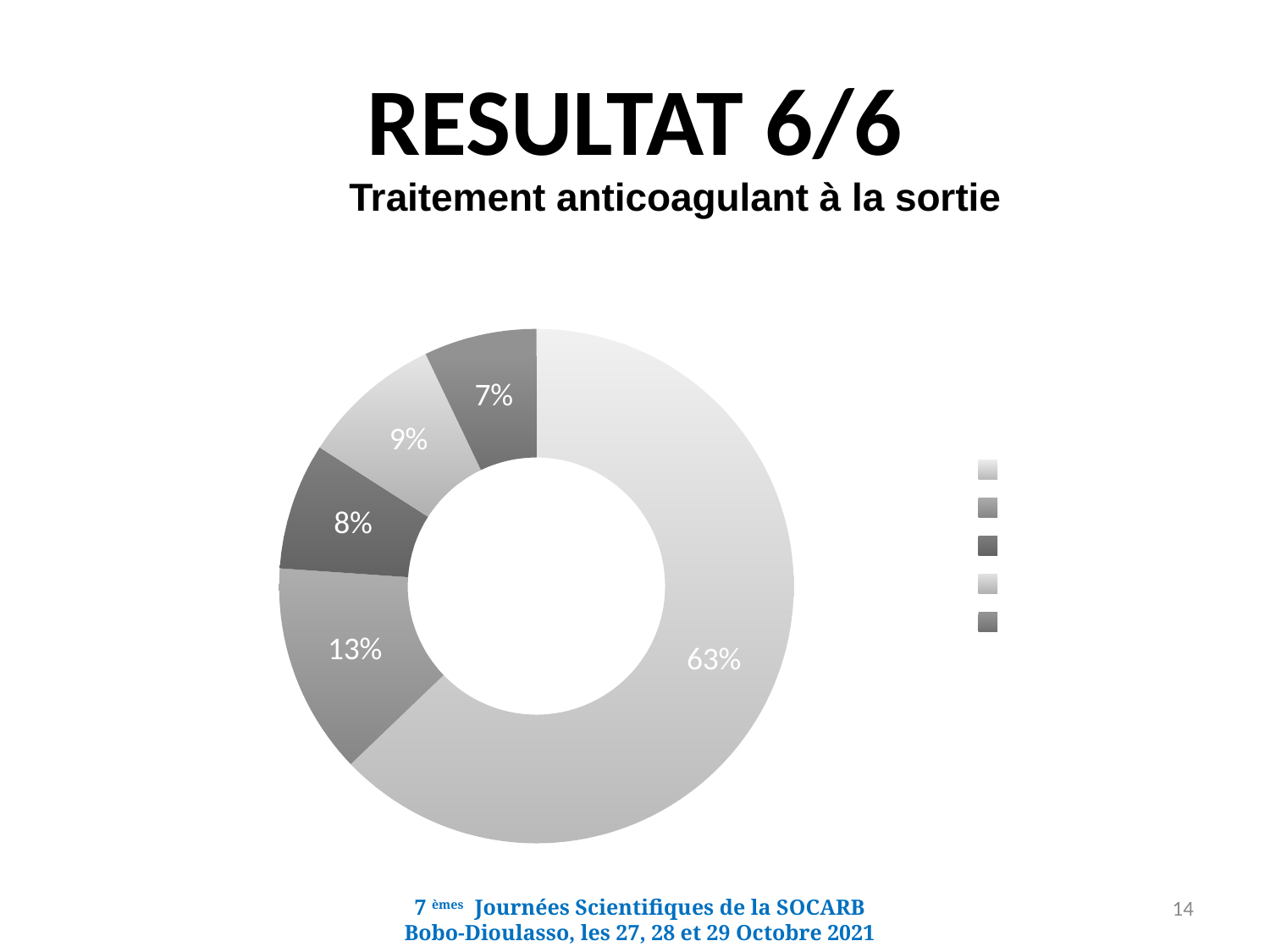
How many entries does the legend show? 5 What is the value of the largest slice in the chart? 63% Is the largest slice greater or less than 50% of the chart? greater How many slices does the doughnut chart have? 5 What type of chart is shown on the slide? Doughnut (pie) chart What is the second-largest slice value shown in the chart? 13% What is the difference between the largest slice (63%) and the smallest slice (7%)? 56% What is the subtitle of the chart on the slide? Traitement anticoagulant à la sortie What is the difference between the 13% slice and the 8% slice? 5% What is the value of the smallest slice in the chart? 7% Which is larger, the 9% slice or the 8% slice? 9% What is the combined share of the four smaller slices (13%, 8%, 9%, 7%)? 37%